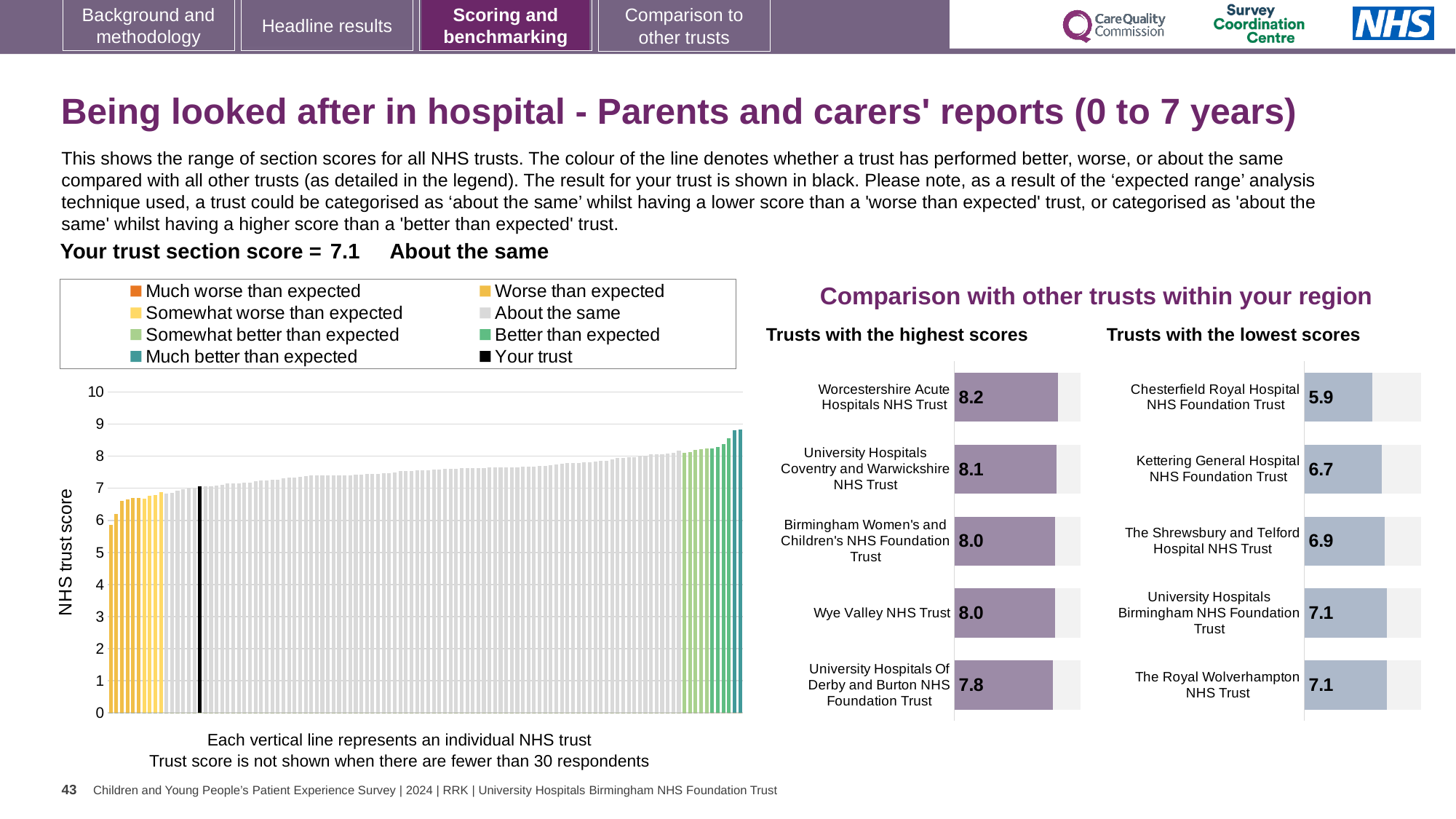
In the 'Trusts with the lowest scores' chart, what is the score for Kettering General Hospital NHS Foundation Trust? 6.7 In the 'Trusts with the lowest scores' chart, what is the difference between the scores of The Royal Wolverhampton NHS Trust and Chesterfield Royal Hospital NHS Foundation Trust? 1.2 How many entries does the legend of the NHS trust score chart on the left list? 8 In the 'Trusts with the highest scores' chart, which trust has the highest score? Worcestershire Acute Hospitals NHS Trust In the NHS trust score chart on the left, what is the section score for your trust (the black bar)? 7.1 In the 'Trusts with the lowest scores' chart, which trust has the lowest score? Chesterfield Royal Hospital NHS Foundation Trust In the NHS trust score chart on the left, do the values rise or fall from left to right? Rise In the 'Trusts with the highest scores' chart, which has the higher score: University Hospitals Coventry and Warwickshire NHS Trust or Birmingham Women's and Children's NHS Foundation Trust? University Hospitals Coventry and Warwickshire NHS Trust In the 'Trusts with the highest scores' chart, what is the difference between the scores of Worcestershire Acute Hospitals NHS Trust and University Hospitals Of Derby and Burton NHS Foundation Trust? 0.4 In the 'Trusts with the highest scores' chart, what is the score for Worcestershire Acute Hospitals NHS Trust? 8.2 What kind of chart is the NHS trust score chart on the left of the slide? Bar chart How many trusts are shown in the 'Trusts with the highest scores' chart? 5